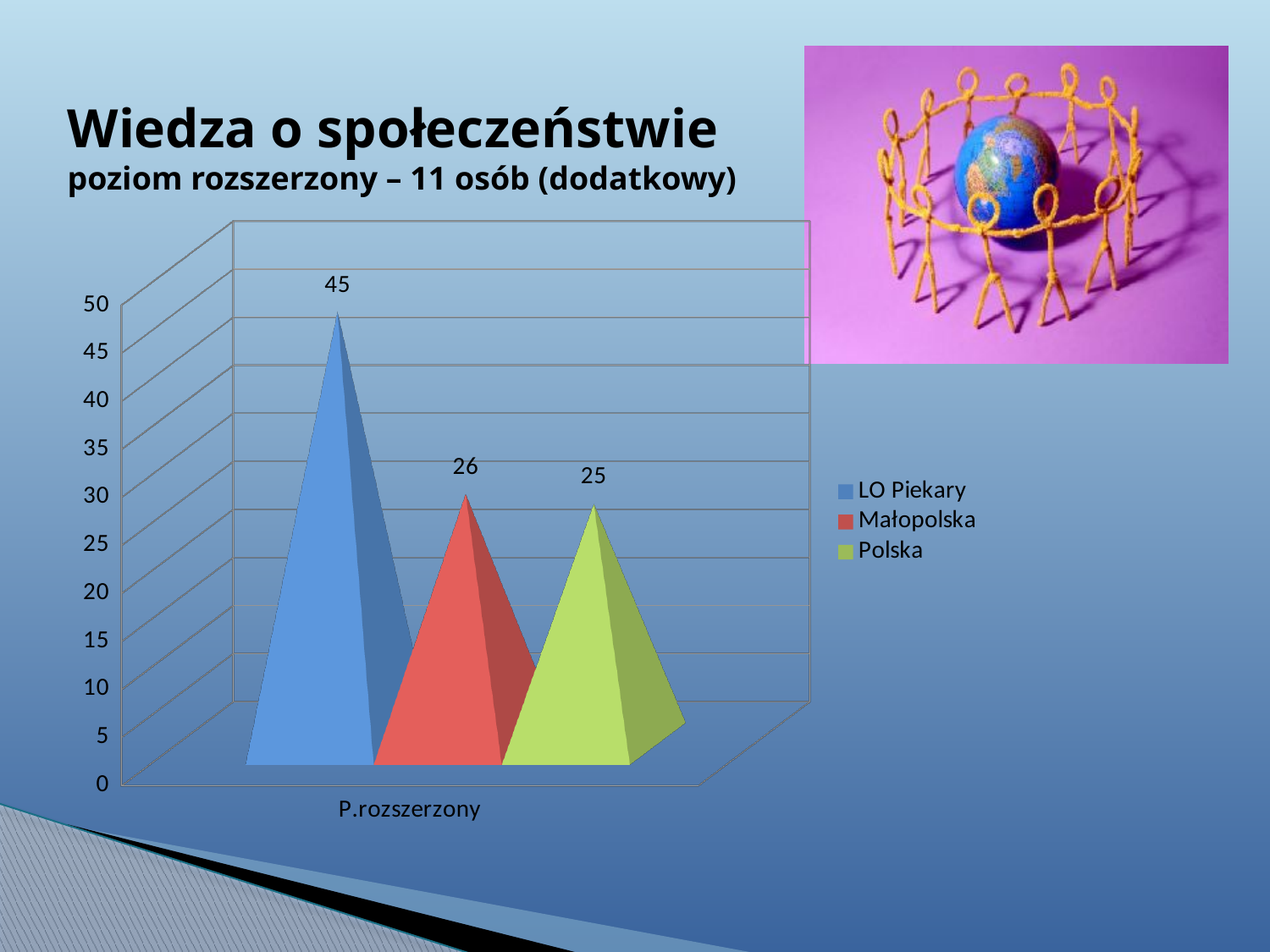
Is the value for LO Piekary greater or less than 40? greater Which series has the lowest value? Polska What kind of chart is shown on the slide? bar chart What is the value for Małopolska in the P.rozszerzony category? 26 Which is larger, the value for LO Piekary or the value for Polska? LO Piekary Which series has the highest value? LO Piekary What colour represents Małopolska in the chart? red What is the value for Polska in the P.rozszerzony category? 25 How many series does the legend list? 3 What is the value for LO Piekary in the P.rozszerzony category? 45 What is the difference between the LO Piekary value and the Polska value? 20 What is the difference between the LO Piekary value and the Małopolska value? 19